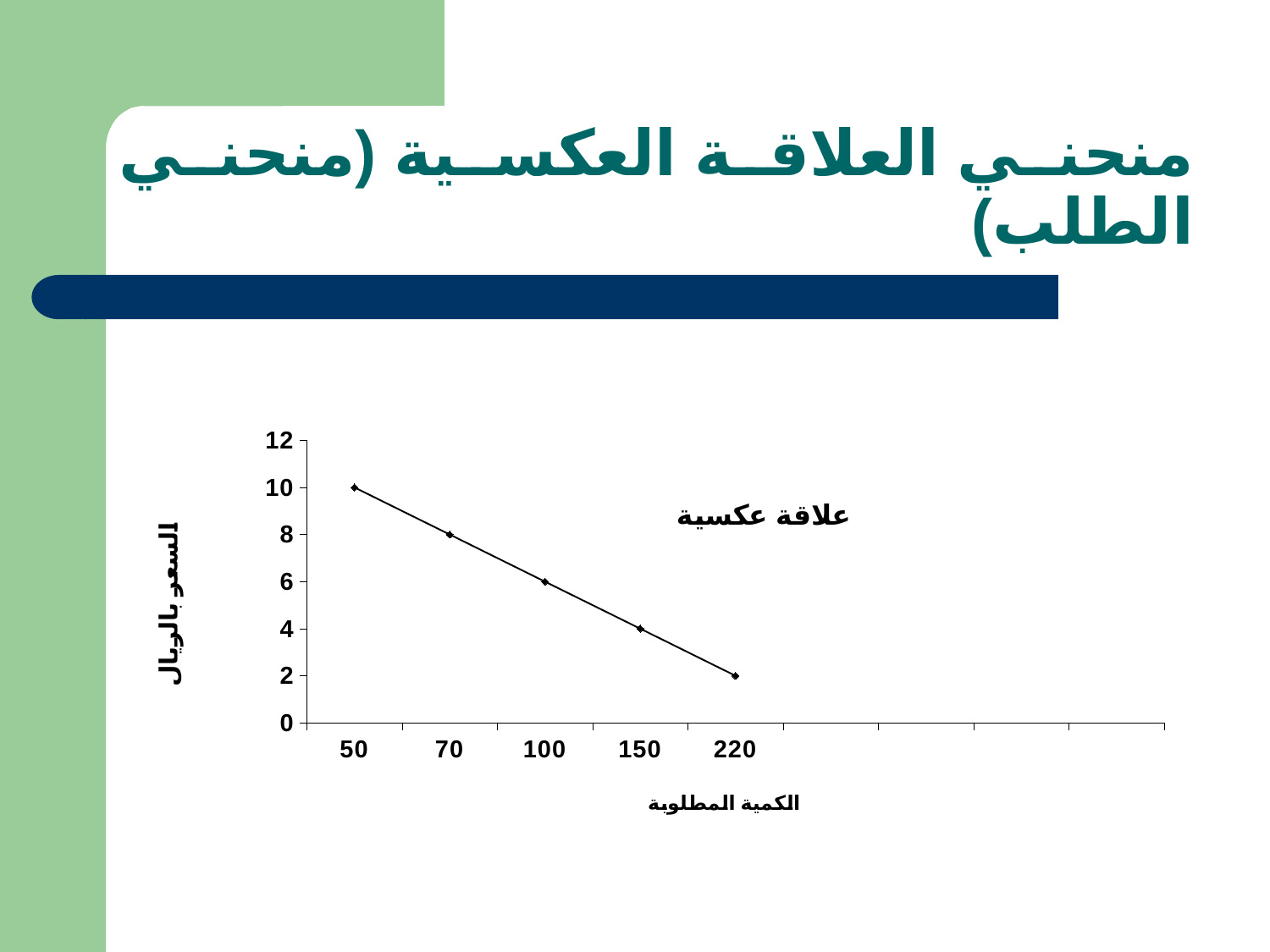
Does the price rise or fall as the quantity demanded increases along the x axis? fall What kind of chart is shown on the slide? line chart What is the price (السعر بالريال) when the quantity demanded is 50? 10 What is the difference between the price at quantity 50 and the price at quantity 150? 6 What is the price when the quantity demanded is 70? 8 What is the price when the quantity demanded is 100? 6 What is the price when the quantity demanded is 220? 2 What is the label of the x axis? الكمية المطلوبة At which quantity demanded is the price highest? 50 At which quantity demanded is the price lowest? 220 How many data points are plotted on the line? 5 Which has a higher price: quantity 70 or quantity 150? 70